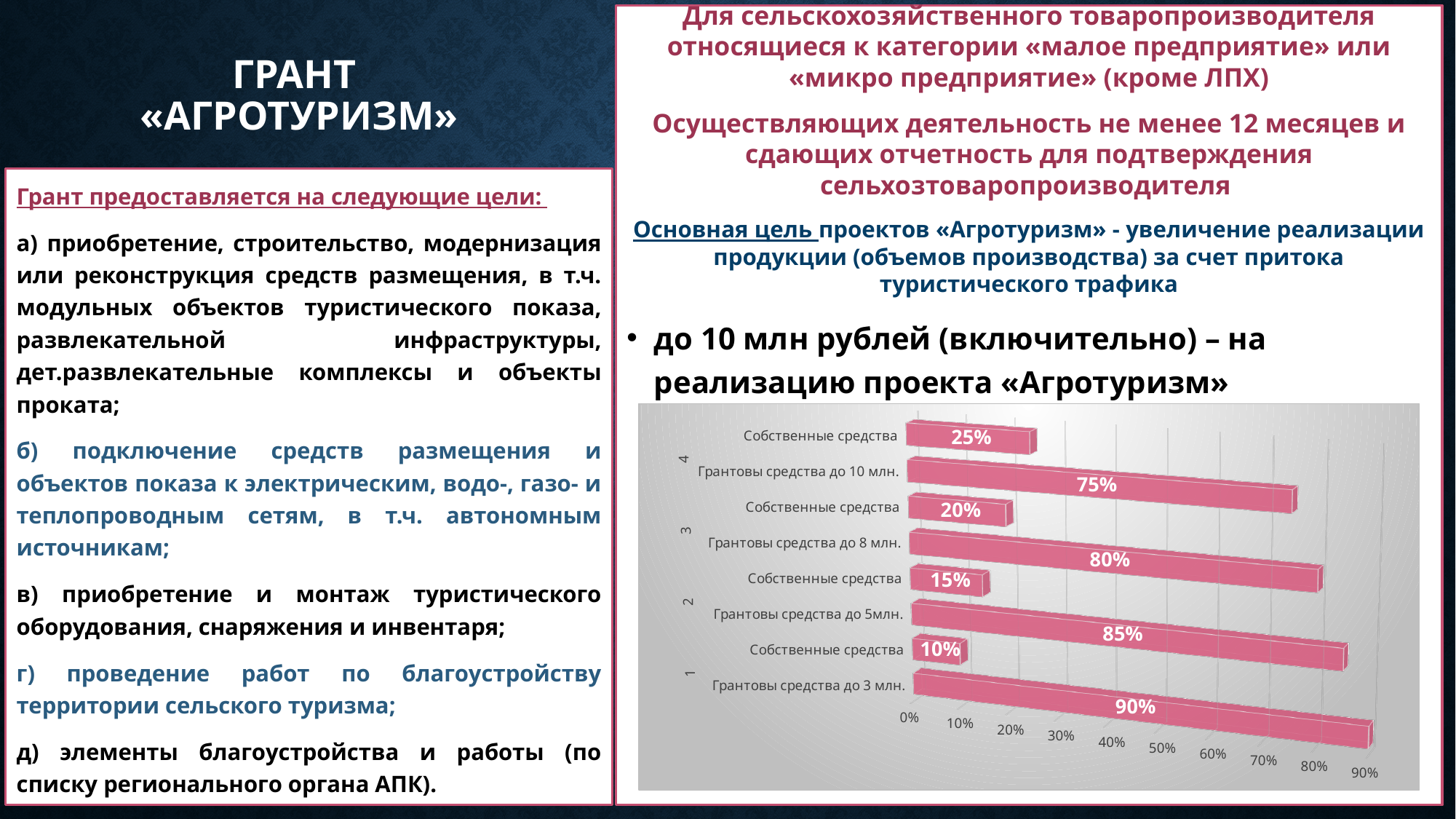
How many bars are plotted in the chart? 8 What is the value for «Грантовы средства до 8 млн.» in the chart? 80% What is the value for «Грантовы средства до 10 млн.» in the chart? 75% What type of chart is shown on the slide? Bar chart What is the value for «Грантовы средства до 3 млн.» in the chart? 90% What is the value for «Собственные средства» in group 1 (the bottom group) of the chart? 10% What is the value for «Собственные средства» in group 4 (the top group) of the chart? 25% What is the difference between «Грантовы средства до 5млн.» and the «Собственные средства» bar in group 2? 70% Which bar in the chart has the highest value? Грантовы средства до 3 млн. What is the total of «Грантовы средства до 5млн.» and the «Собственные средства» bar in group 2? 100% Which is larger: «Грантовы средства до 10 млн.» or «Грантовы средства до 8 млн.»? Грантовы средства до 8 млн. Which bar in the chart has the lowest value? Собственные средства (group 1)